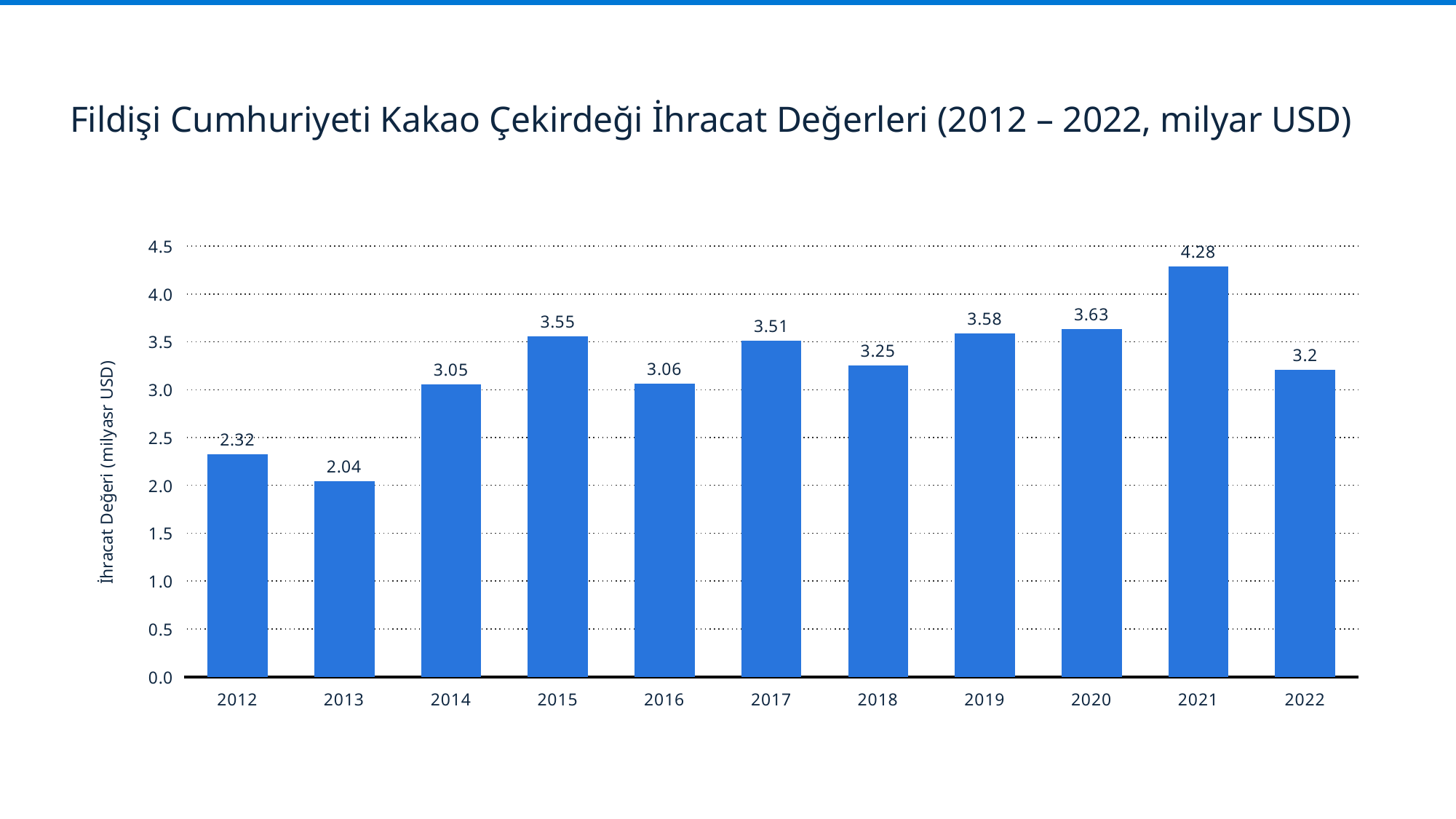
Which year has the lowest export value? 2013 What is the export value for 2021? 4.28 Which is larger, the export value for 2015 or for 2017? 2015 What is the export value for 2013? 2.04 What is the label of the y axis? İhracat Değeri (milyasr USD) How many years are shown on the x axis? 11 What is the export value for 2022? 3.2 Is the value for 2018 greater or less than 3.0? greater Which year has the highest export value? 2021 What is the difference between the export values for 2012 and 2013? 0.28 What is the difference between the export values for 2021 and 2022? 1.08 What kind of chart is shown on the slide? bar chart